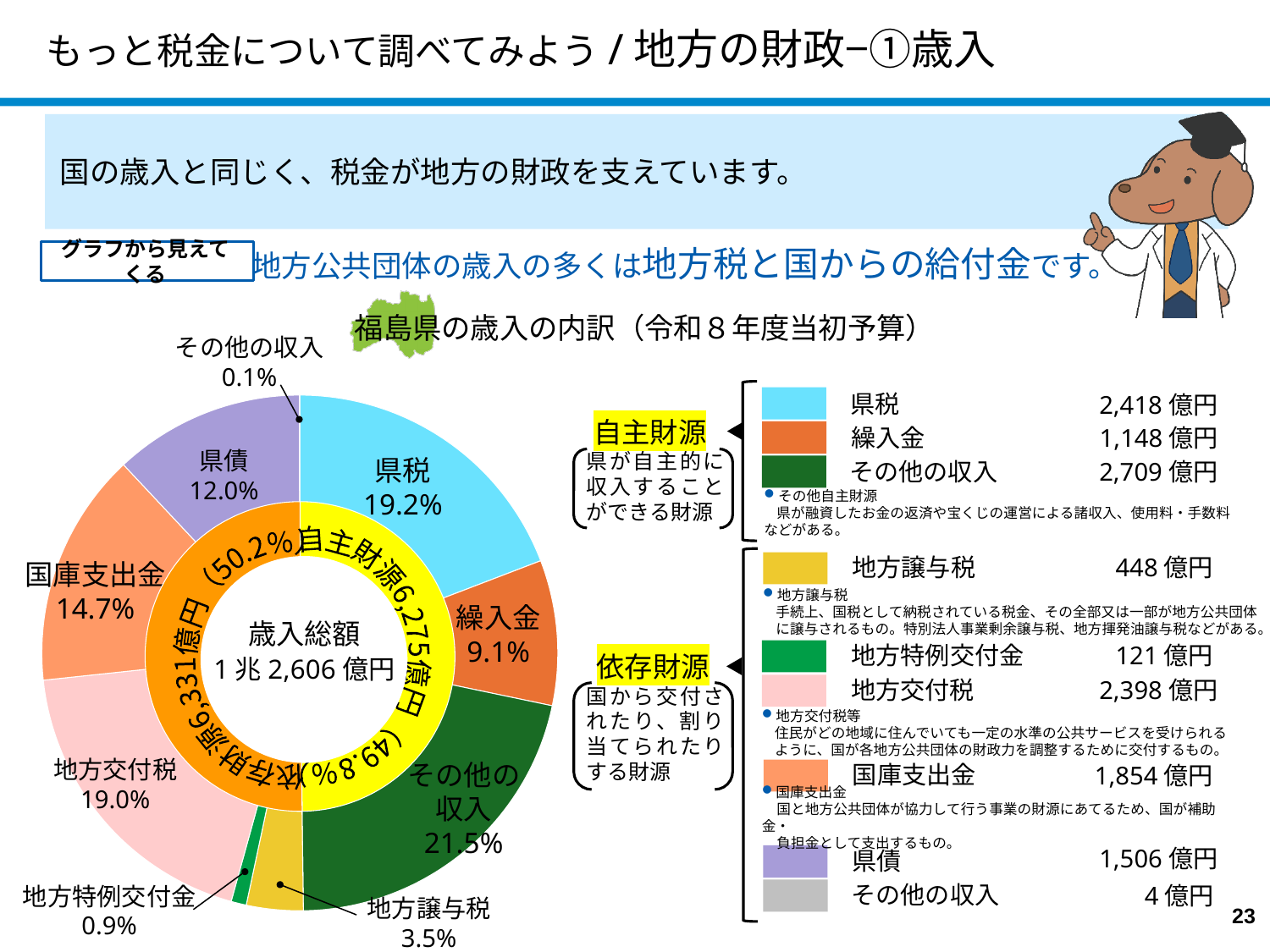
グラフの内側の円で自主財源の割合は何％ですか？ 50.2% グラフで県債（12.0%）と繰入金（9.1%）の割合の差は何ポイントですか？ 2.9ポイント グラフのタイトルは何ですか？ 福島県の歳入の内訳（令和８年度当初予算） グラフの外側の円で最も割合が小さい項目はどれですか？ その他の収入（依存財源、0.1%） グラフで地方譲与税の割合は何％ですか？ 3.5% このスライドのグラフはどの種類のグラフですか？ 円グラフ（ドーナツグラフ） グラフで県債と繰入金では、どちらの割合が大きいですか？ 県債 グラフの外側の円で最も割合が大きい項目はどれですか？ その他の収入（自主財源、21.5%） グラフの中央に示されている歳入総額はいくらですか？ 1兆2,606億円 グラフの外側の円にはいくつの項目がありますか？ 9 グラフで国庫支出金の割合は何％ですか？ 14.7% グラフで県税の割合は何％ですか？ 19.2%